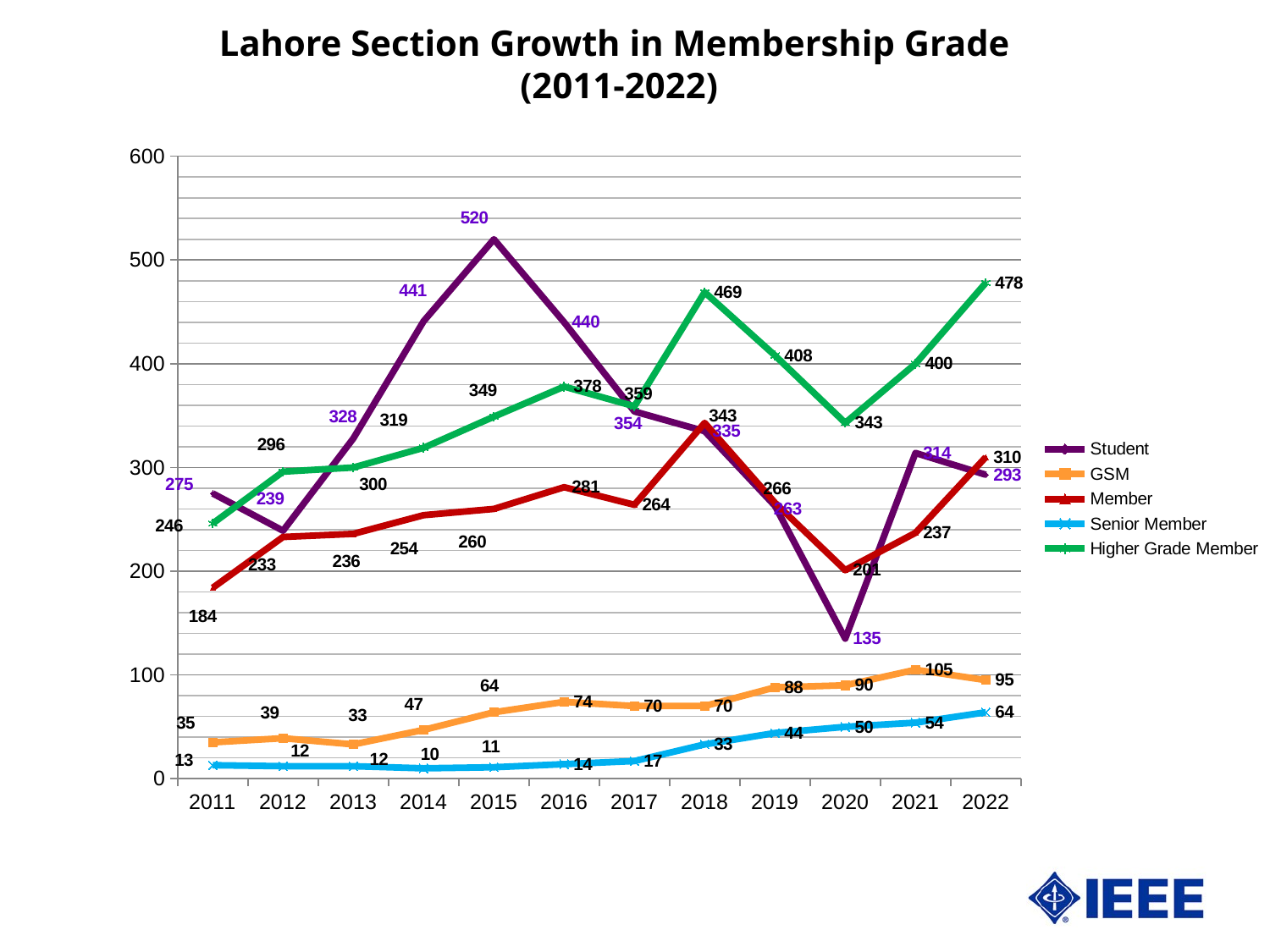
How many years are plotted along the x axis? 12 In 2020, which is larger: Higher Grade Member or Member? Higher Grade Member Does the Senior Member series rise or fall from 2017 to 2022? rise What kind of chart is shown on the slide? line chart In which year does the Student series reach its highest value? 2015 How many series does the legend list? 5 What is the GSM value in 2021? 105 In which year is the Senior Member value lowest? 2014 What is the Student value in 2015? 520 What is the difference between the Member values in 2022 and 2021? 73 In which year does the Student series reach its lowest value? 2020 What is the Higher Grade Member value in 2022? 478